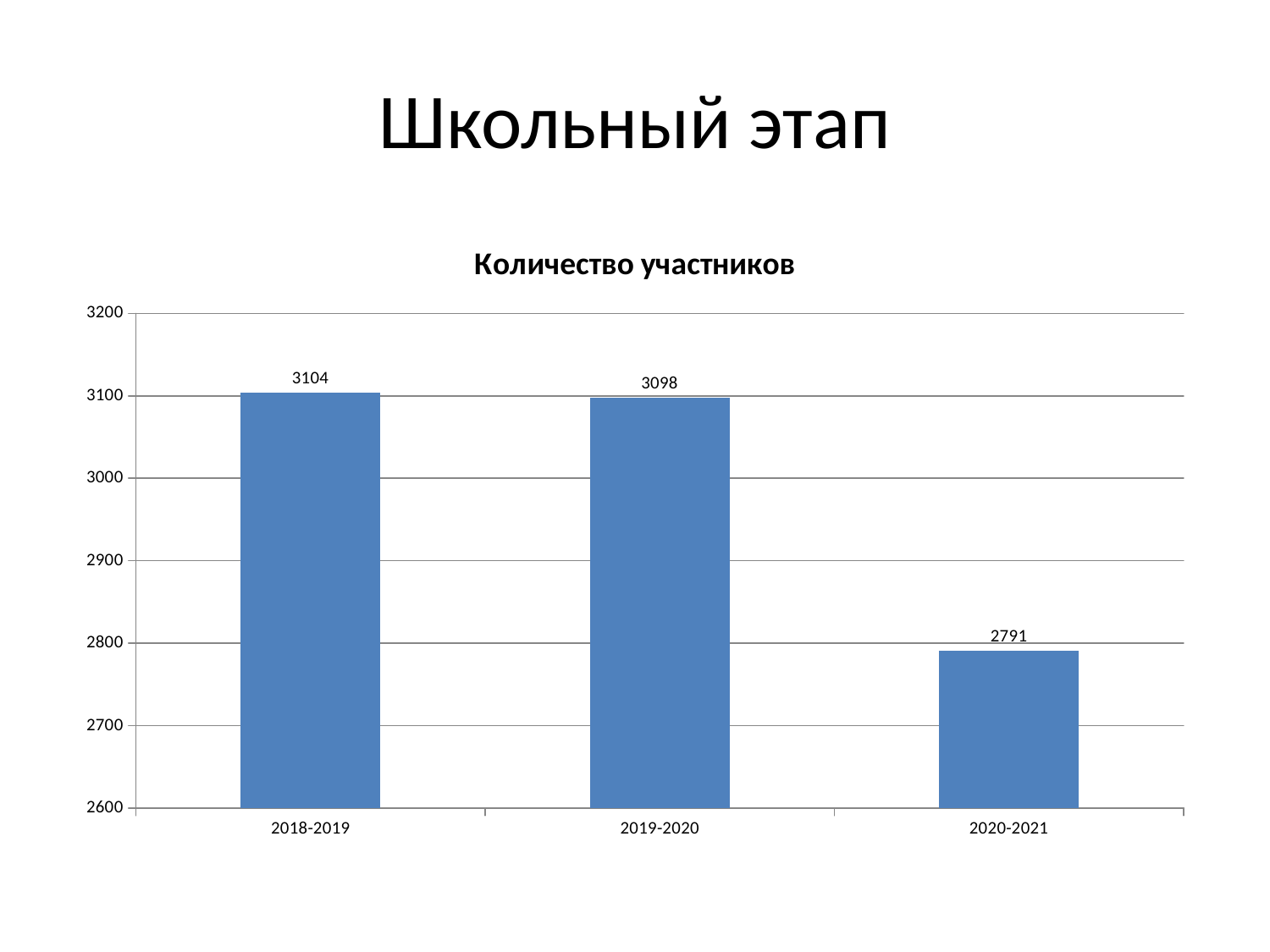
What is the value for 2020-2021? 2791 Which category has the lowest value? 2020-2021 How many categories are shown on the x axis? 3 What is the difference between the values for 2018-2019 and 2020-2021? 313 What is the value for 2018-2019? 3104 What kind of chart is shown on the slide? bar chart Is the value for 2018-2019 greater or less than 3000? greater Is the value for 2020-2021 greater or less than 2800? less Which is larger, the value for 2019-2020 or the value for 2020-2021? 2019-2020 What is the title of the chart? Количество участников What is the difference between the values for 2019-2020 and 2020-2021? 307 What is the value for 2019-2020? 3098